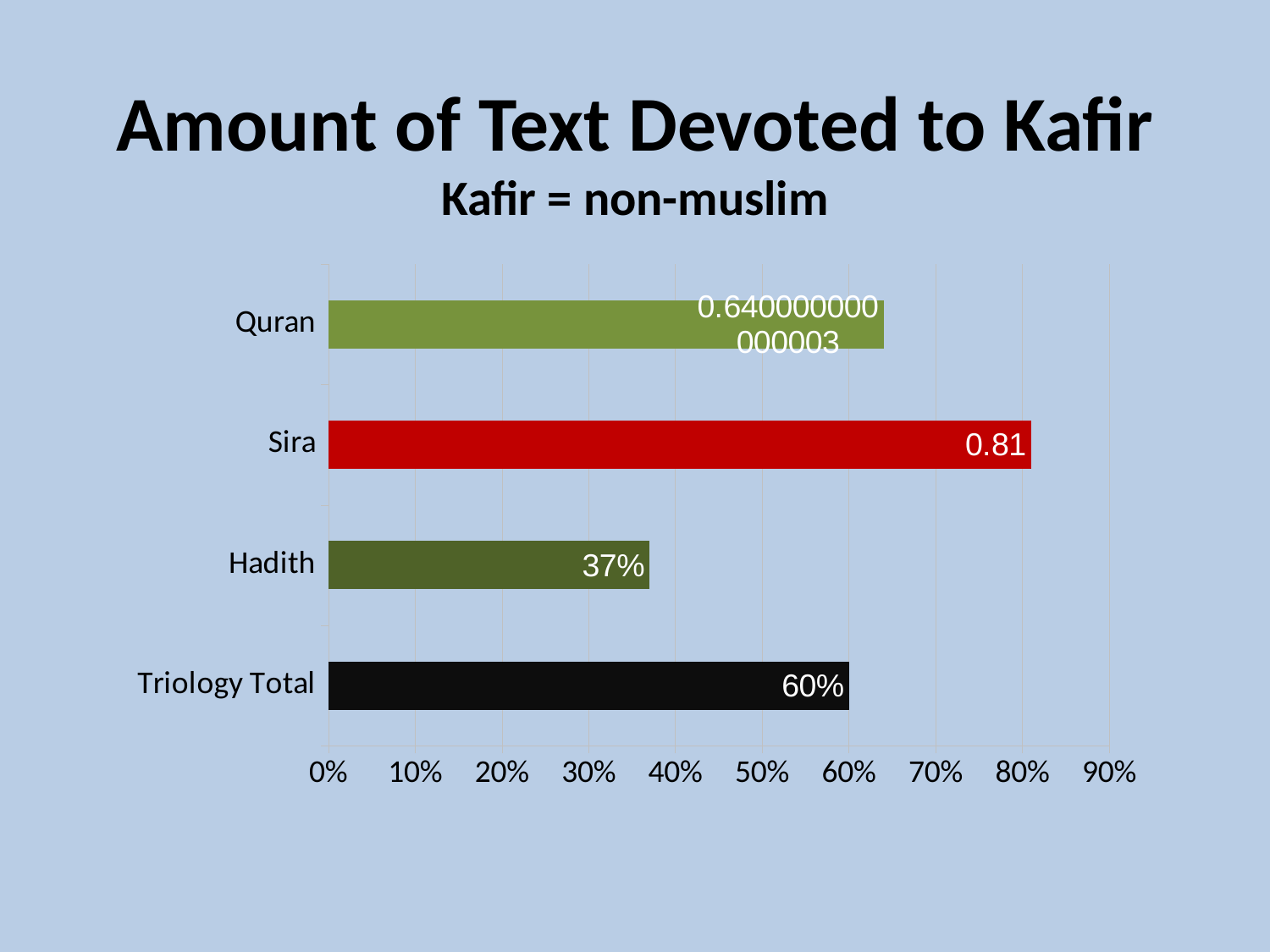
What kind of chart is shown on the slide? bar chart Which category has the highest value? Sira How many categories are shown in the chart? 4 What is the title of the slide? Amount of Text Devoted to Kafir What is the value shown for Triology Total? 60% What is the difference between the Triology Total value and the Hadith value? 23% What is the value shown for Sira? 0.81 What data label is printed on the Quran bar? 0.640000000000003 Which category has the lowest value? Hadith Is the value for Quran greater or less than 60%? greater Which is larger, the value for Sira or the value for Quran? Sira What is the value shown for Hadith? 37%